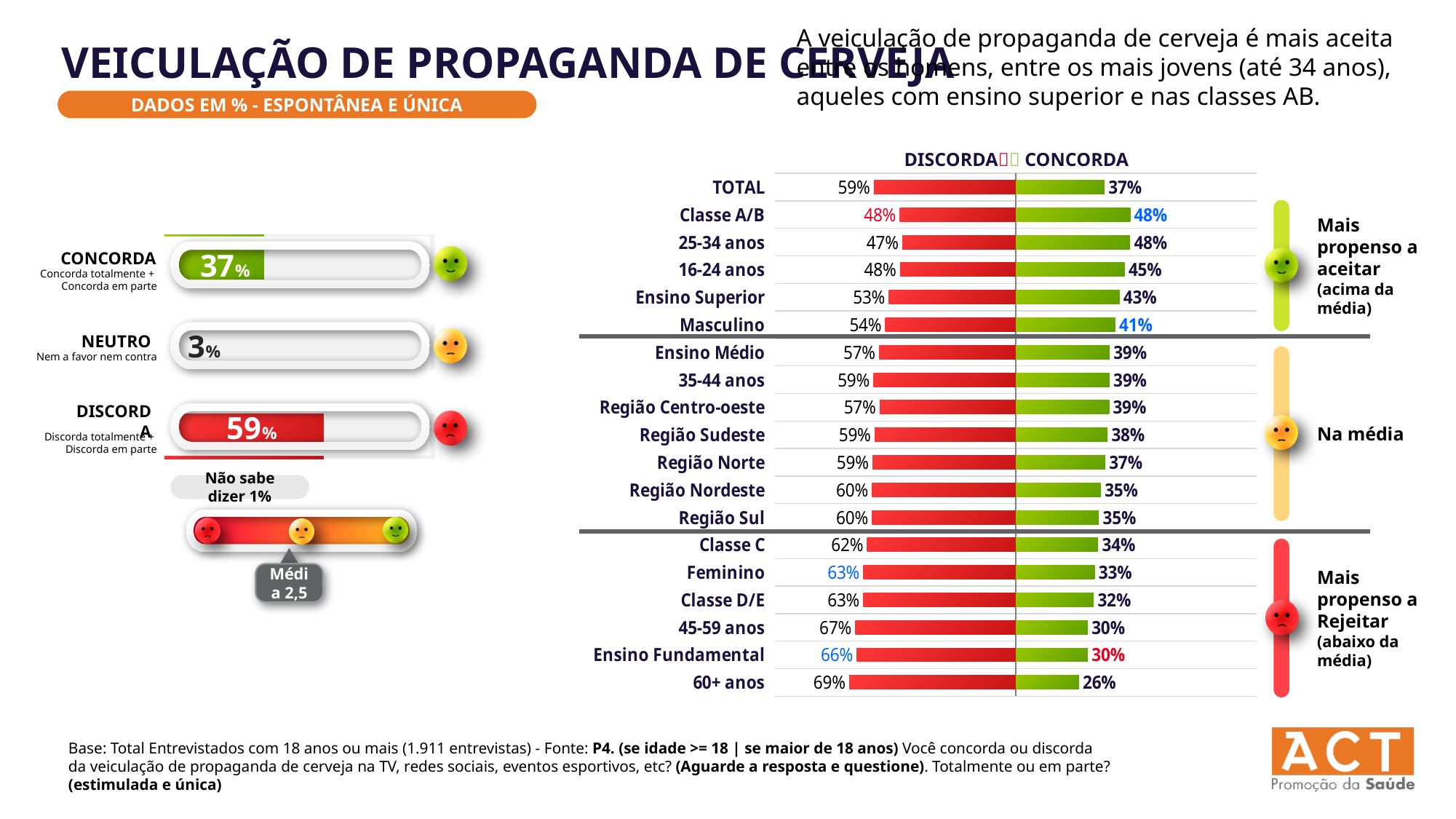
In the right chart (DISCORDA / CONCORDA by segment), how many segment rows are shown, including TOTAL? 19 In the left chart, what percentage of respondents answered CONCORDA? 37% In the right chart (DISCORDA / CONCORDA by segment), which segment has the highest DISCORDA value? 60+ anos In the right chart (DISCORDA / CONCORDA by segment), which segment has the lowest CONCORDA value? 60+ anos In the right chart (DISCORDA / CONCORDA by segment), which has a higher CONCORDA value, Masculino or Feminino? Masculino In the left chart, what is the difference between the DISCORDA and CONCORDA percentages? 22% In the right chart (DISCORDA / CONCORDA by segment), which segment has the lowest DISCORDA value? 25-34 anos In the right chart (DISCORDA / CONCORDA by segment), what is the DISCORDA value for Feminino? 63% In the left chart, what percentage of respondents answered DISCORDA? 59% In the right chart (DISCORDA / CONCORDA by segment), what is the difference between the DISCORDA values for 60+ anos and 16-24 anos? 21% In the left chart, what is the value for NEUTRO? 3% In the right chart (DISCORDA / CONCORDA by segment), what is the CONCORDA value for Ensino Superior? 43%